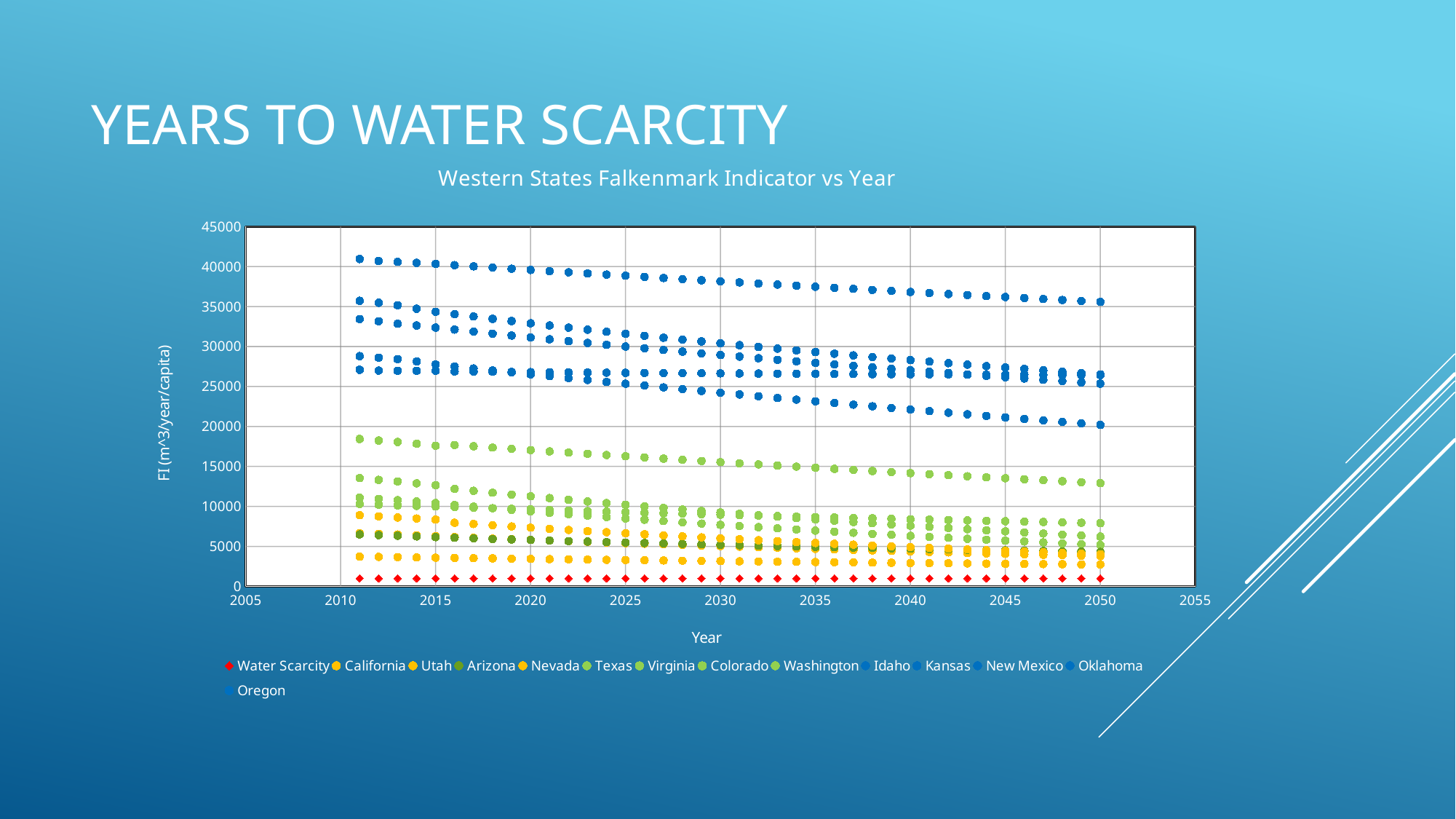
Is the highest plotted value in 2011 greater or less than 40000? greater What kind of chart is shown on the slide? scatter chart Does the Water Scarcity series rise, fall, or stay flat across the years? stay flat Is the lowest state series value in 2050 greater or less than 5000? less How many series does the chart legend list? 14 What is the title of the chart? Western States Falkenmark Indicator vs Year Is the value of the Water Scarcity series greater or less than 5000? less What is the label on the vertical axis of the chart? FI (m^3/year/capita) Do the state series values generally rise or fall as the year increases? fall